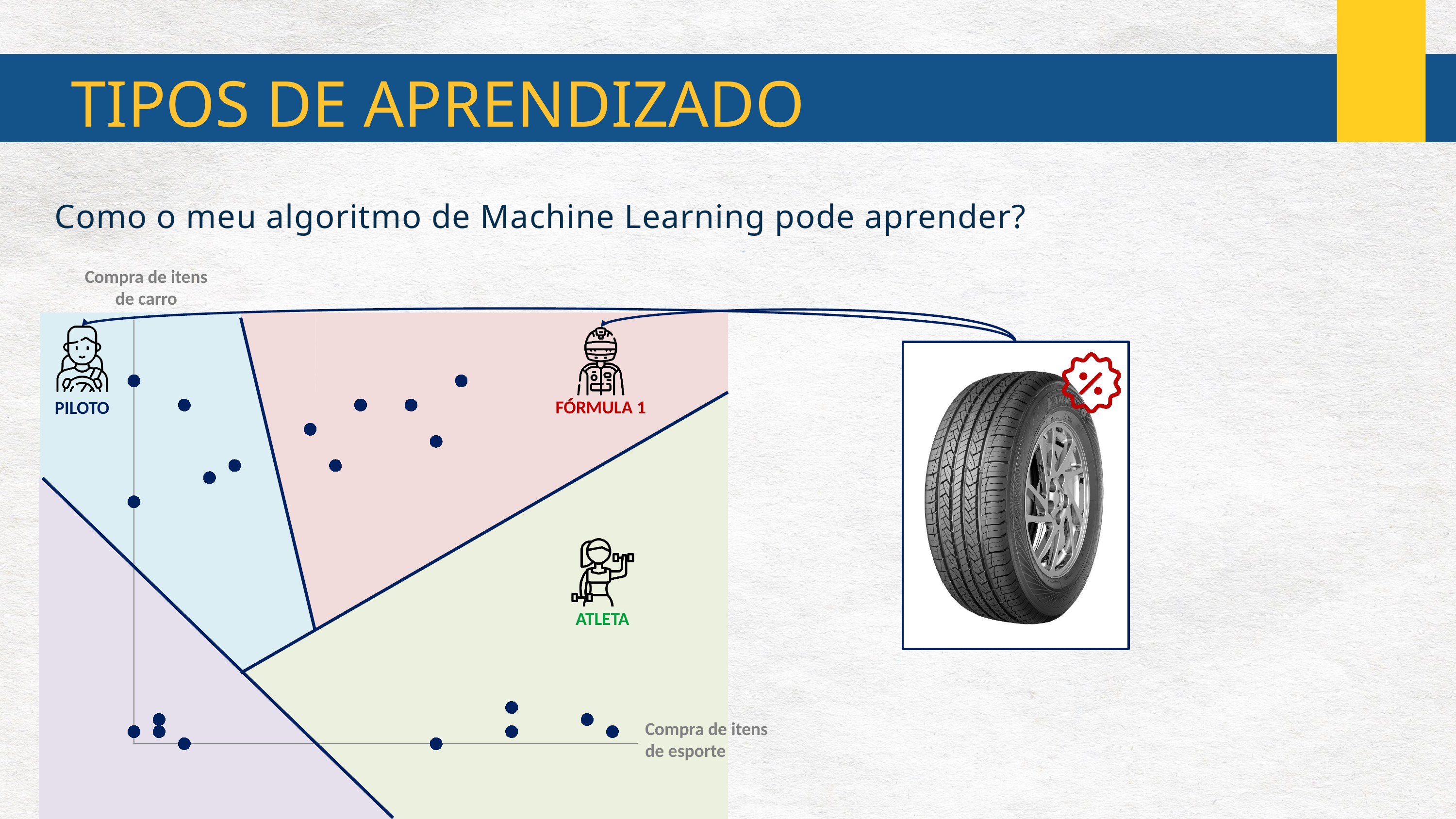
What is the label of the horizontal axis of the scatter plot? Compra de itens de esporte How many data points are plotted in the FÓRMULA 1 region of the scatter plot? 6 What is the label of the vertical axis of the scatter plot? Compra de itens de carro Which labeled group in the scatter plot has points with high car-item purchases but low sport-item purchases? PILOTO How many labeled groups (regions) are shown in the scatter plot? 3 Which labeled group in the scatter plot has points with high values on both axes (car items and sport items)? FÓRMULA 1 Which labeled group in the scatter plot has points with high sport-item purchases but low car-item purchases? ATLETA How many data points are plotted in the PILOTO region of the scatter plot? 5 What kind of chart is shown on the slide? scatter plot